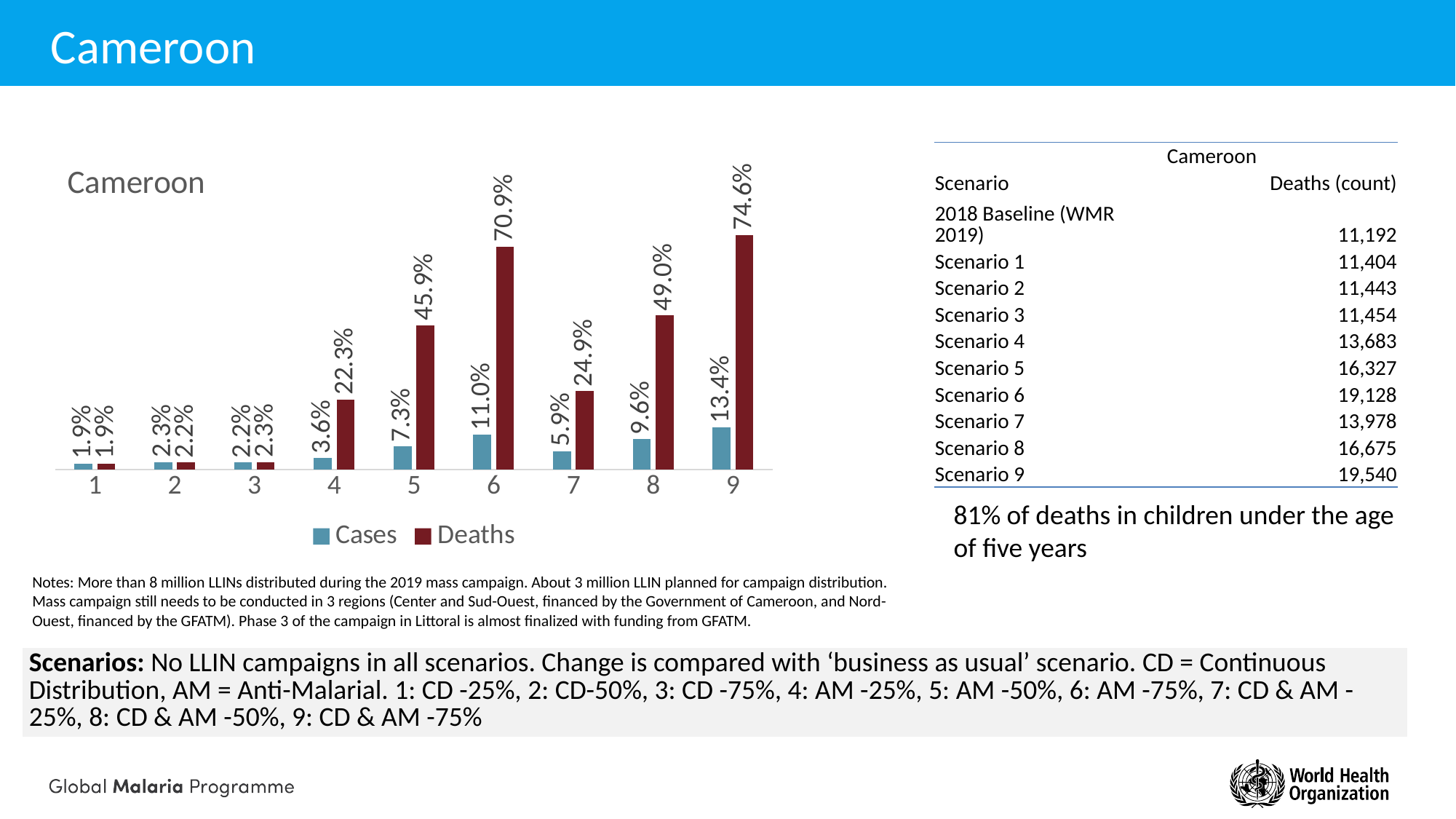
What is the Cases value for scenario 9 in the chart? 13.4% Which series is shown in dark red in the chart? Deaths What kind of chart is shown on the slide? Bar chart What is the Cases value for scenario 5 in the chart? 7.3% Which scenario has the highest Deaths value in the chart? 9 What is the difference between the Deaths and Cases values for scenario 8? 39.4% Which is larger for scenario 7: the Cases value or the Deaths value? Deaths How many series does the chart legend list? 2 What is the Deaths value for scenario 4 in the chart? 22.3% How many scenarios are plotted on the x axis of the chart? 9 Which scenario has the lowest Cases value in the chart? 1 What is the Deaths value for scenario 6 in the chart? 70.9%